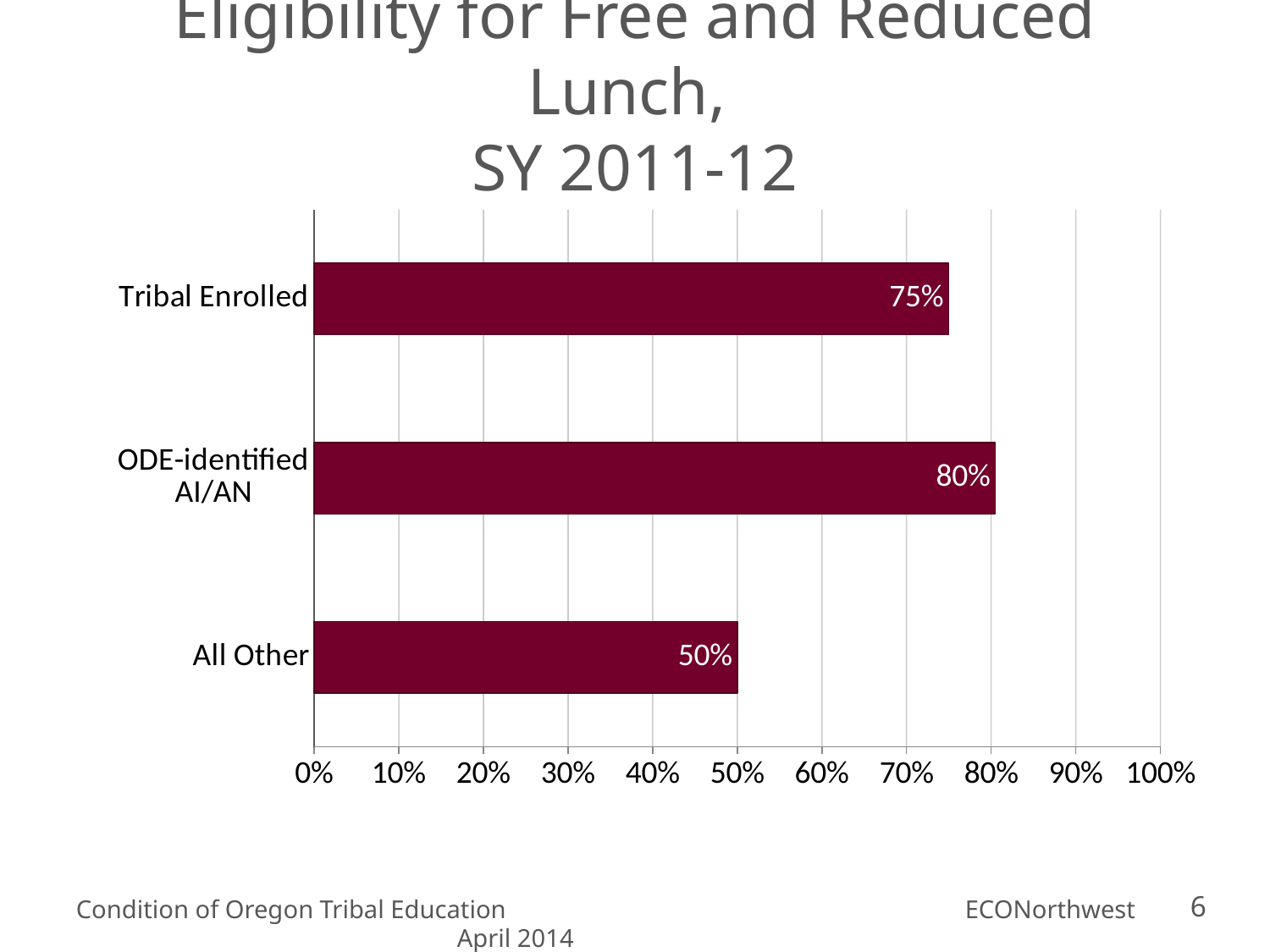
What school year does the chart title refer to? SY 2011-12 Which is larger, the value for Tribal Enrolled or the value for All Other? Tribal Enrolled What kind of chart is shown on the slide? bar chart What is the value for Tribal Enrolled? 75% Is the value for Tribal Enrolled greater or less than 70%? greater What is the value for All Other? 50% Which category has the lowest value? All Other What is the difference between the values for ODE-identified AI/AN and All Other? 30% How many categories are shown in the chart? 3 Which category has the highest value? ODE-identified AI/AN What is the difference between the values for ODE-identified AI/AN and Tribal Enrolled? 5% What is the value for ODE-identified AI/AN? 80%